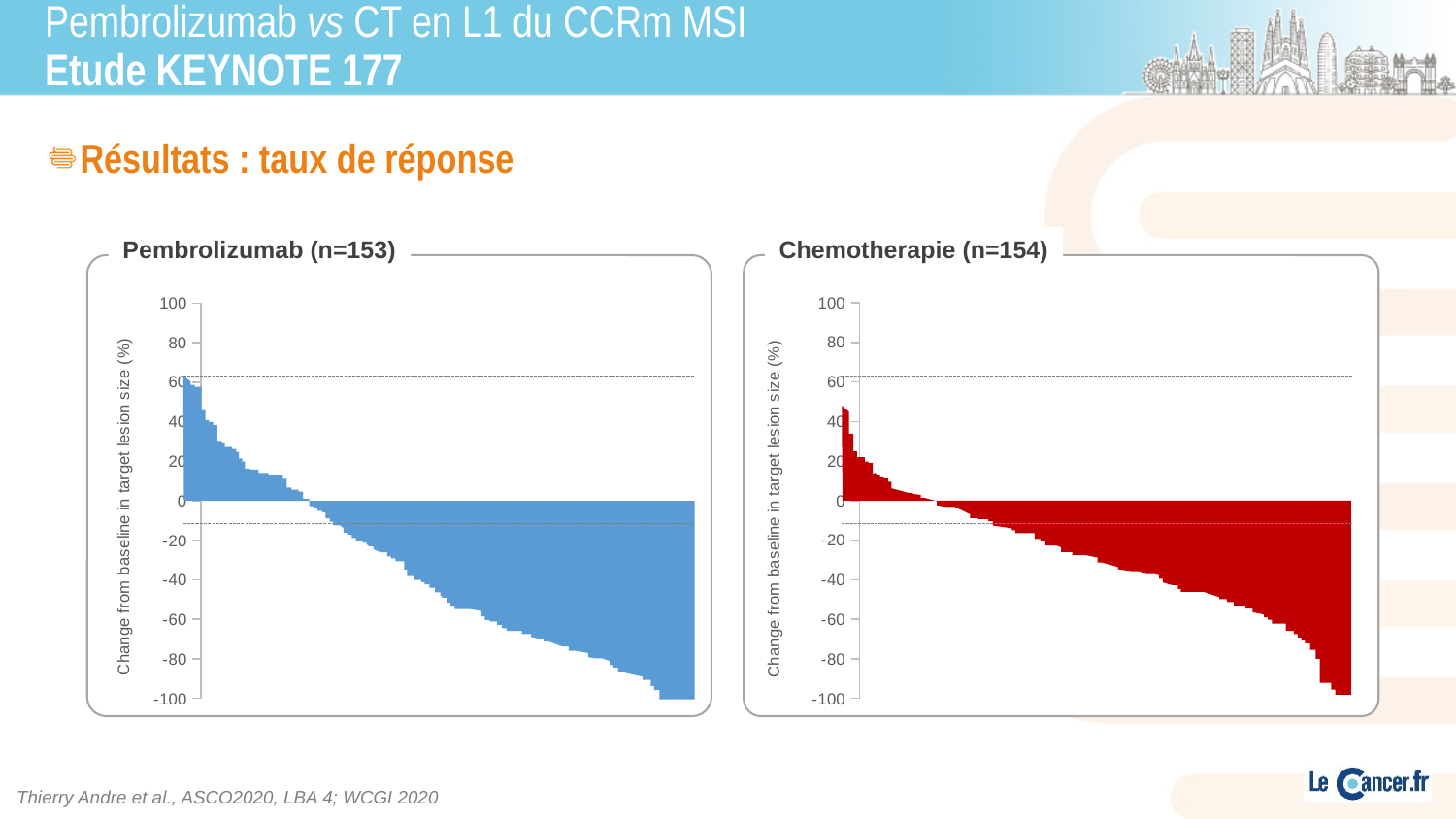
What is the y-axis label of the Chemotherapie (n=154) chart? Change from baseline in target lesion size (%) In the Chemotherapie (n=154) chart, do the bar values rise or fall from left to right? fall How many patients are represented in the Pembrolizumab chart, according to its title? 153 In the Pembrolizumab (n=153) chart, is the value of the lowest bar greater or less than -80? less Which chart has the larger maximum positive change from baseline, Pembrolizumab (n=153) or Chemotherapie (n=154)? Pembrolizumab (n=153) What kind of chart is the Pembrolizumab (n=153) chart? bar chart In the Chemotherapie (n=154) chart, is the value of the tallest positive bar greater or less than 60? less In the Pembrolizumab (n=153) chart, do the bar values rise or fall from left to right? fall How many patients are represented in the Chemotherapie chart, according to its title? 154 What kind of chart is the Chemotherapie (n=154) chart? bar chart What is the title of the left chart? Pembrolizumab (n=153) In the Pembrolizumab (n=153) chart, is the value of the tallest positive bar greater or less than 40? greater